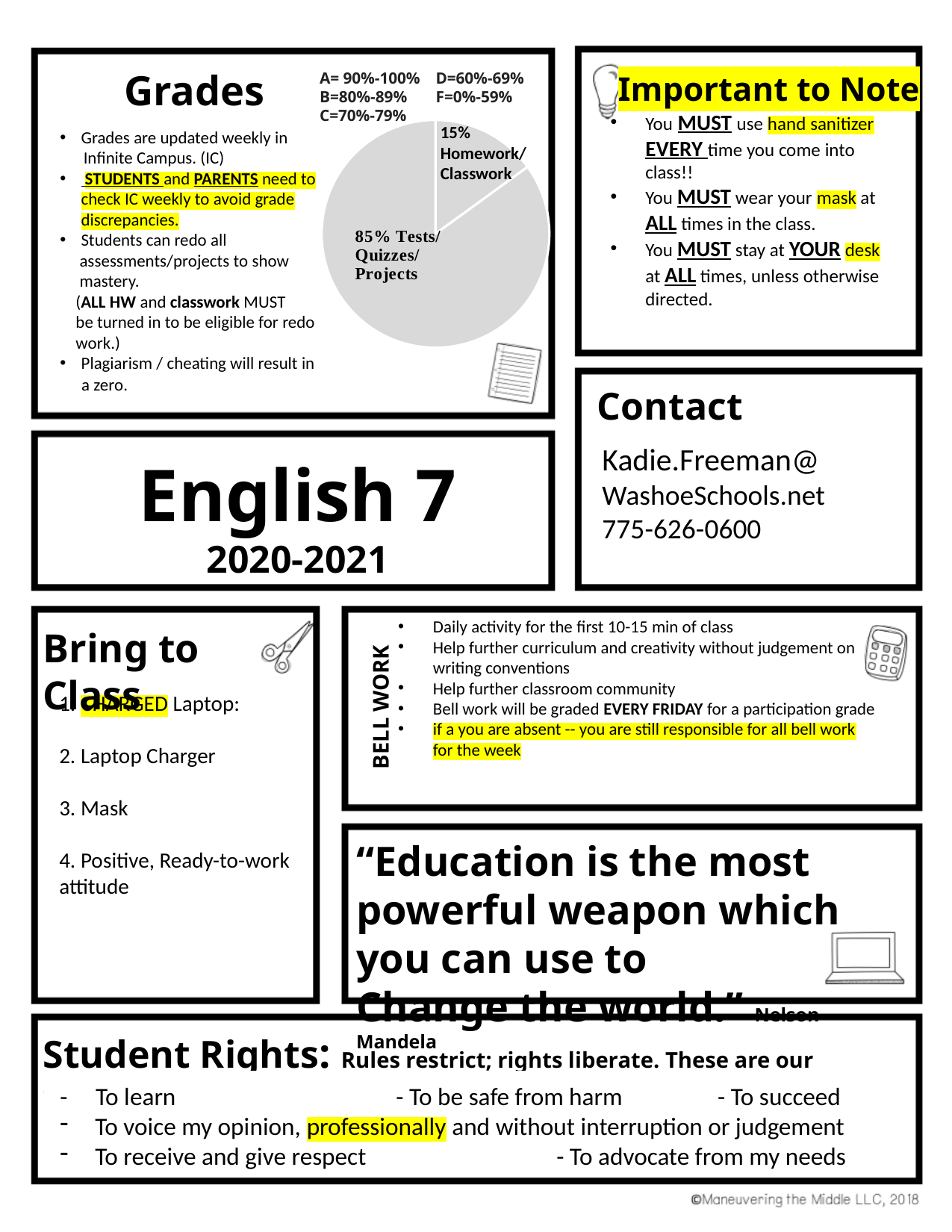
Which slice of the pie chart is the largest? Tests/Quizzes/Projects What kind of chart is shown in the Grades section? pie chart Is the Homework/Classwork share in the pie chart greater or less than 50%? less Which is larger in the pie chart, Homework/Classwork or Tests/Quizzes/Projects? Tests/Quizzes/Projects Under which section heading does the pie chart appear? Grades What share of the grade does the Tests/Quizzes/Projects slice represent in the pie chart? 85% By how many percentage points does the Tests/Quizzes/Projects slice exceed the Homework/Classwork slice in the pie chart? 70 What share of the grade does the Homework/Classwork slice represent in the pie chart? 15% Which slice of the pie chart is the smallest? Homework/Classwork What is the combined total of the two slices shown in the pie chart? 100% How many slices does the pie chart in the Grades section have? 2